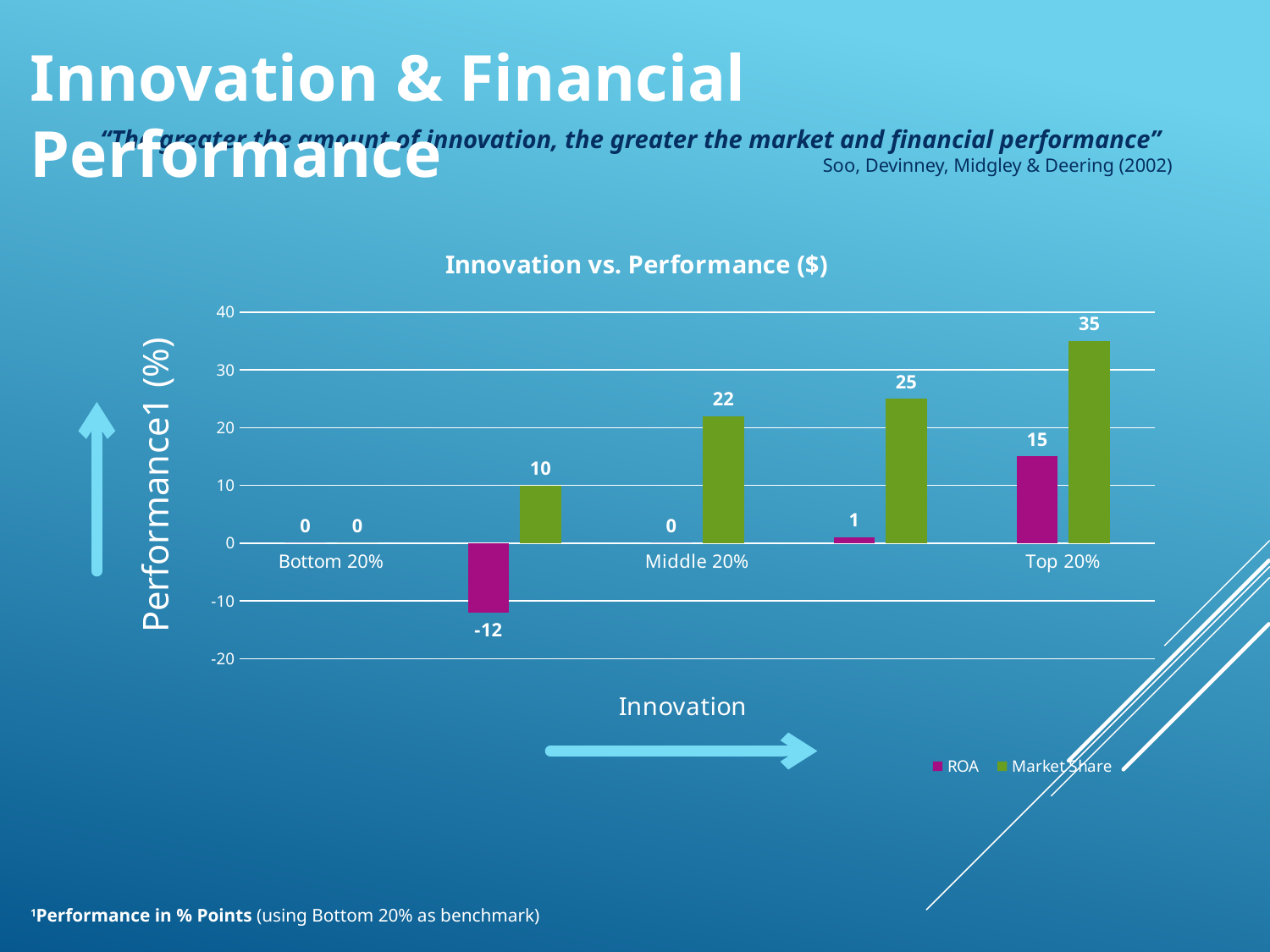
What is the ROA value for Top 20%? 15 What is the Market Share value for Bottom 20%? 0 What is the ROA value for Middle 20%? 0 What kind of chart is shown on the slide? Bar chart What is the difference between the Market Share values for Top 20% and Middle 20%? 13 What is the difference between the Market Share and ROA values for Top 20%? 20 What is the Market Share value for Top 20%? 35 How many series does the legend list? 2 What is the title of the chart? Innovation vs. Performance ($) What is the Market Share value for Middle 20%? 22 Which category has the highest Market Share value? Top 20% Which is larger for Top 20%, the ROA value or the Market Share value? Market Share